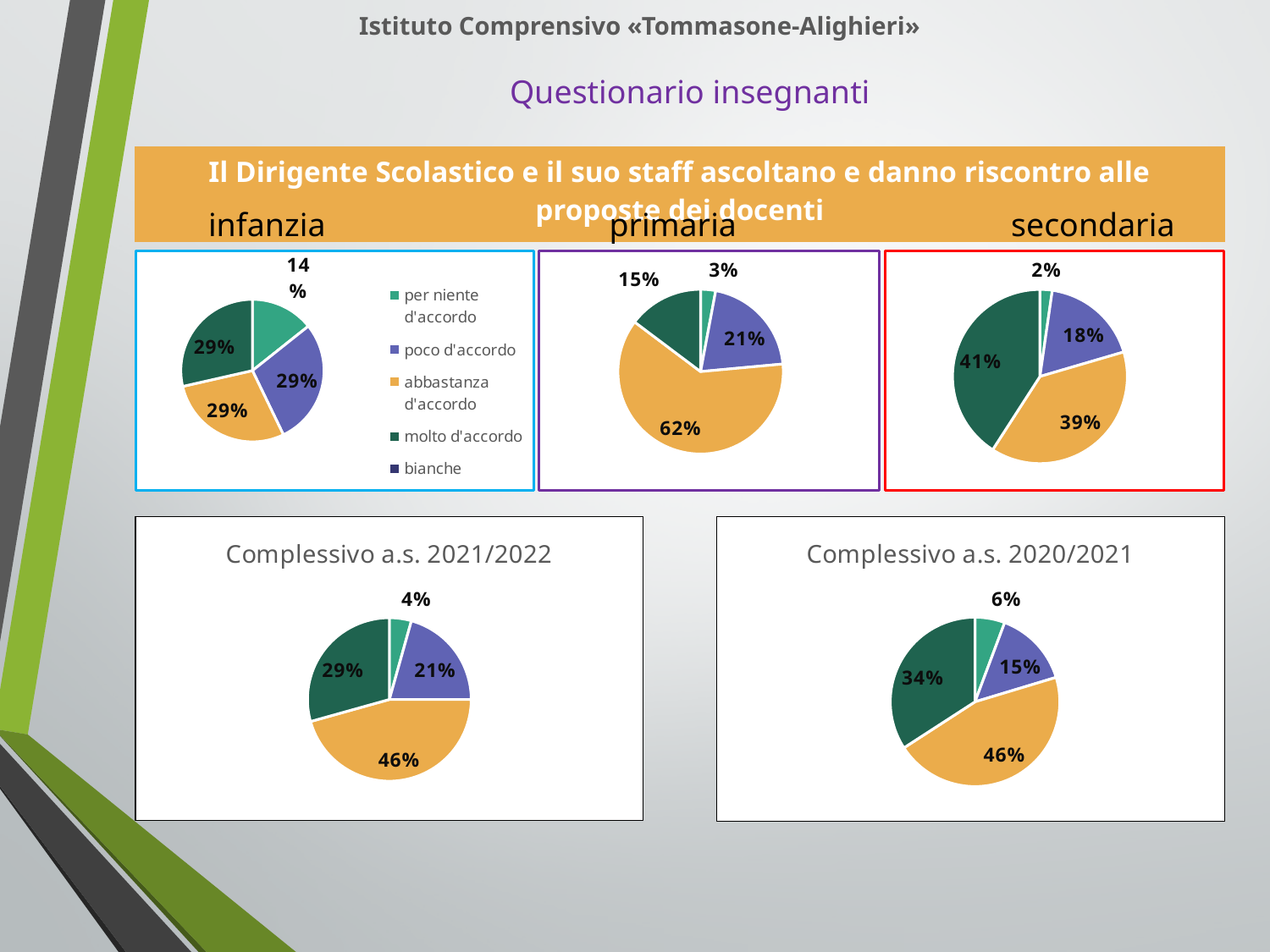
How many entries does the legend in the 'infanzia' chart list? 5 What kind of chart is used for 'Complessivo a.s. 2021/2022'? pie chart In the 'secondaria' pie chart, what share is 'molto d'accordo'? 41% In the 'Complessivo a.s. 2020/2021' pie chart, what share is 'molto d'accordo'? 34% In the 'Complessivo a.s. 2020/2021' pie chart, what is the difference between the 'abbastanza d'accordo' share and the 'molto d'accordo' share? 12% In the 'Complessivo a.s. 2021/2022' pie chart, what share is 'poco d'accordo'? 21% In the 'secondaria' pie chart, which category has the smallest share? per niente d'accordo Which is larger: the 'per niente d'accordo' share in 'Complessivo a.s. 2021/2022' or in 'Complessivo a.s. 2020/2021'? Complessivo a.s. 2020/2021 In the 'primaria' pie chart, what share is 'abbastanza d'accordo'? 62% In the 'infanzia' pie chart, what share is 'per niente d'accordo'? 14% In the 'primaria' pie chart, which category has the largest share? abbastanza d'accordo How many pie charts are shown on the slide? 5